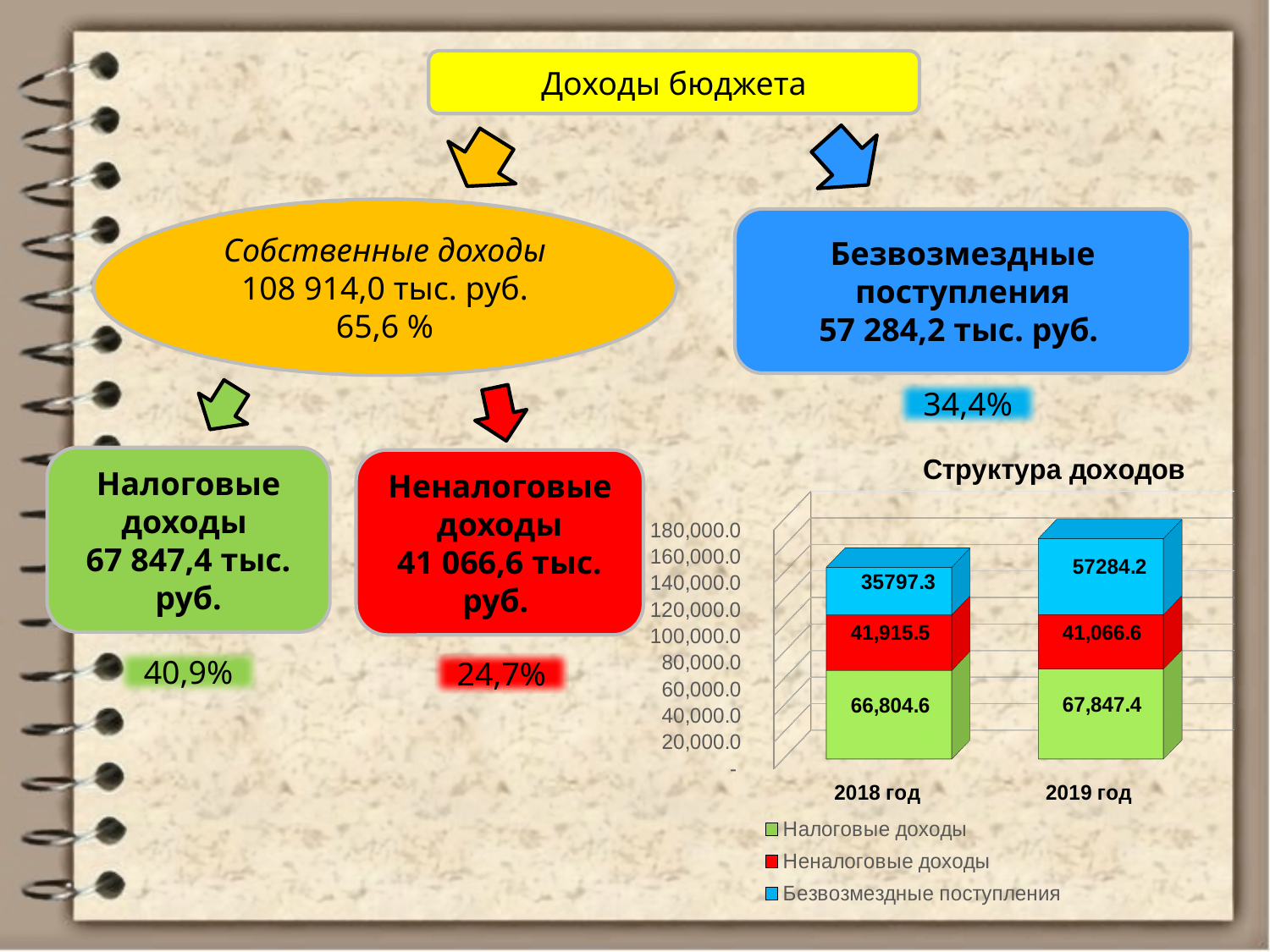
What is the title of the chart on the slide? Структура доходов In the 'Структура доходов' chart, what is the total of the stacked bar for 2019 год? 166,198.2 How many series does the legend of the 'Структура доходов' chart list? 3 In the 'Структура доходов' chart, by how much did Безвозмездные поступления increase from 2018 год to 2019 год? 21,486.9 What kind of chart is shown under the title 'Структура доходов'? stacked bar chart How many categories (years) are shown on the x axis of the 'Структура доходов' chart? 2 In the 'Структура доходов' chart, what is the value of Налоговые доходы for 2018 год? 66,804.6 In the 'Структура доходов' chart, what is the total of the stacked bar for 2018 год? 144,517.4 In the 'Структура доходов' chart, what is the value of Неналоговые доходы for 2018 год? 41,915.5 In the 'Структура доходов' chart, what is the value of Безвозмездные поступления for 2019 год? 57284.2 In the 'Структура доходов' chart, which series is shown in red? Неналоговые доходы In the 'Структура доходов' chart, which year has the larger value for Безвозмездные поступления, 2018 год or 2019 год? 2019 год